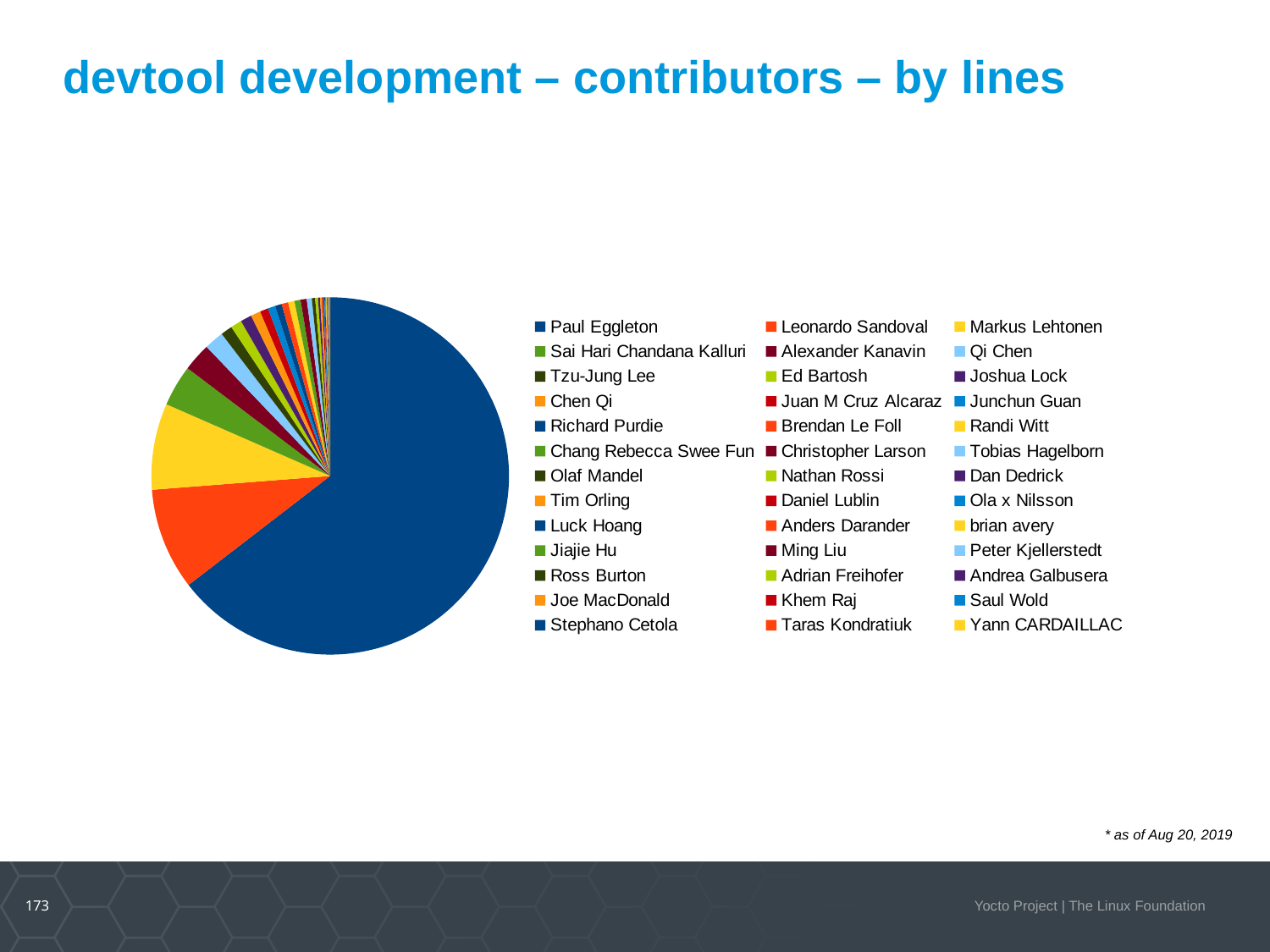
Which slice is larger, Paul Eggleton's or Leonardo Sandoval's? Paul Eggleton Which slice is larger, Leonardo Sandoval's or Chen Qi's? Leonardo Sandoval How many contributors are listed in the legend? 39 What kind of chart is shown on the slide? pie chart What is the title of the slide containing the pie chart? devtool development – contributors – by lines Which contributor has the largest slice of the pie? Paul Eggleton Which contributor is listed first in the legend? Paul Eggleton Does Paul Eggleton's slice account for more or less than half of the pie? more Which slice is larger, Sai Hari Chandana Kalluri's or Tzu-Jung Lee's? Sai Hari Chandana Kalluri